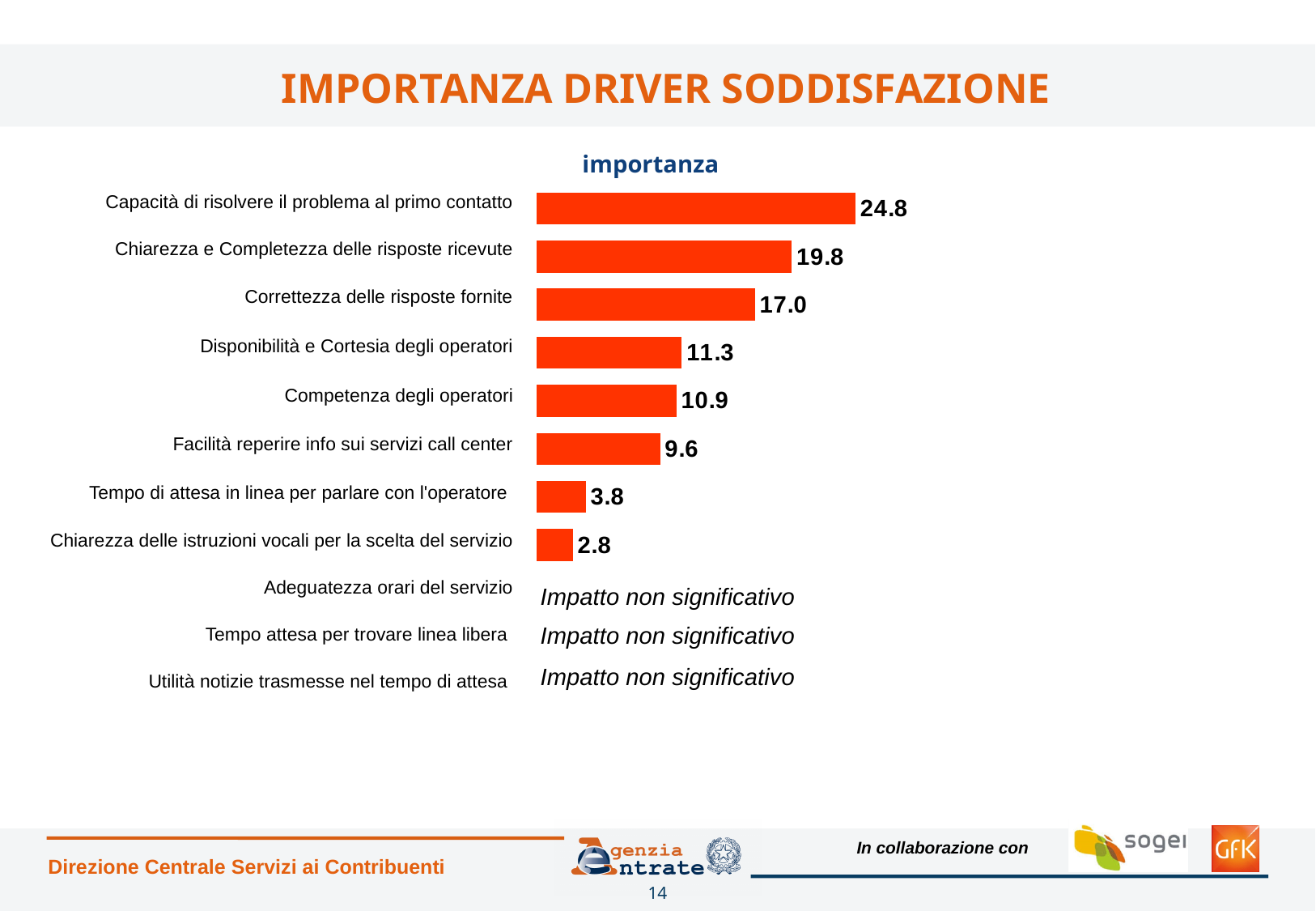
What is the difference between the importance values of 'Tempo di attesa in linea per parlare con l'operatore' and 'Chiarezza delle istruzioni vocali per la scelta del servizio'? 1.0 What type of chart is shown on the slide? Bar chart How many drivers have a plotted bar with a numeric importance value? 8 What is the difference between the importance values of 'Capacità di risolvere il problema al primo contatto' and 'Chiarezza e Completezza delle risposte ricevute'? 5.0 Which driver has the highest importance value? Capacità di risolvere il problema al primo contatto What is the importance value for 'Chiarezza delle istruzioni vocali per la scelta del servizio'? 2.8 What is the importance value for 'Capacità di risolvere il problema al primo contatto'? 24.8 What is the title of the chart? importanza What is the importance value for 'Competenza degli operatori'? 10.9 What is shown for 'Adeguatezza orari del servizio' instead of a bar? Impatto non significativo Which has a higher importance value: 'Correttezza delle risposte fornite' or 'Disponibilità e Cortesia degli operatori'? Correttezza delle risposte fornite Among the drivers with a plotted bar, which has the lowest importance value? Chiarezza delle istruzioni vocali per la scelta del servizio